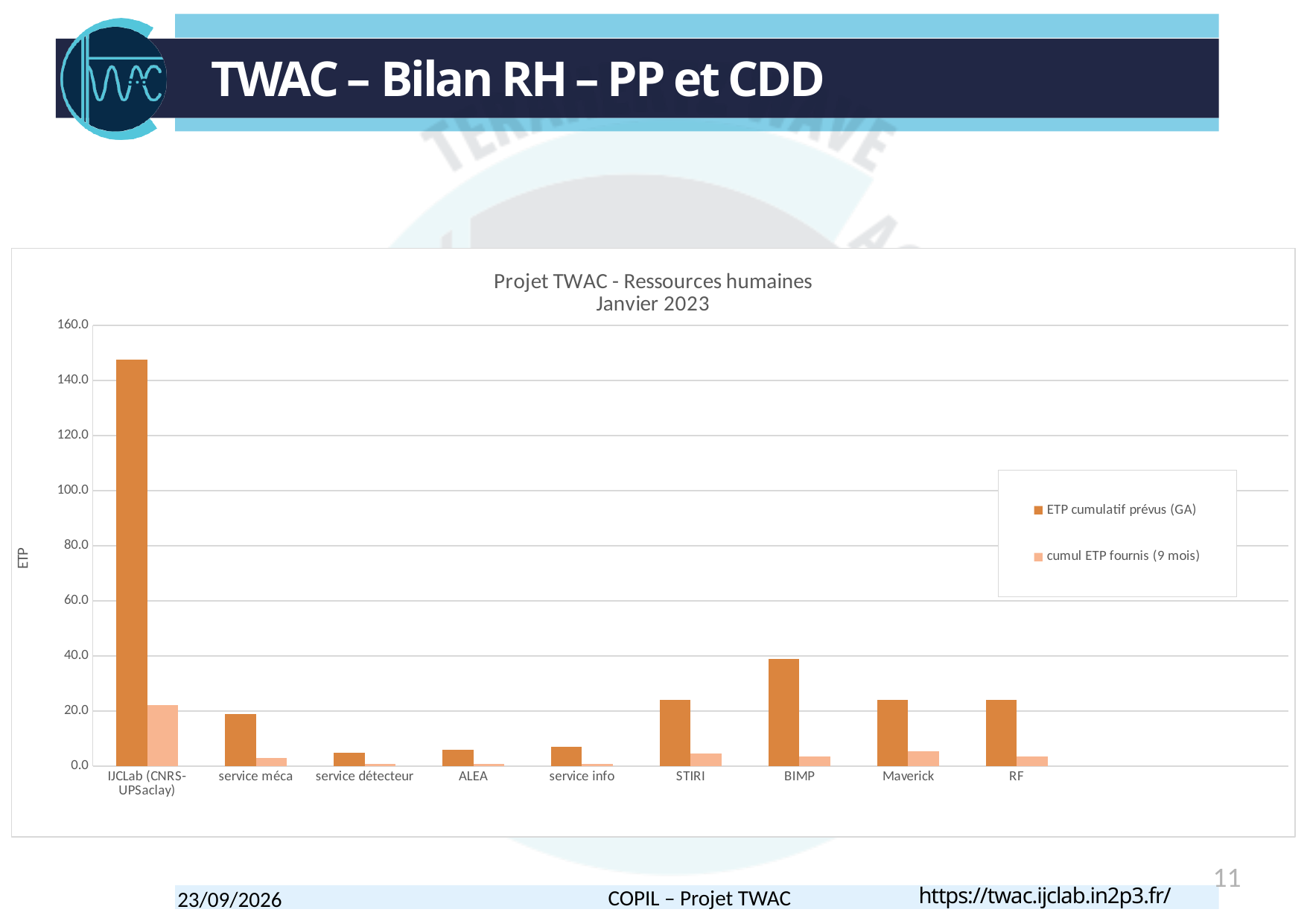
Which category has the highest value for ETP cumulatif prévus (GA)? IJCLab (CNRS-UPSaclay) Which is larger, the ETP cumulatif prévus (GA) value for BIMP or for STIRI? BIMP How many categories are shown on the x axis? 9 Is the ETP cumulatif prévus (GA) value for BIMP greater or less than 20? greater Is the cumul ETP fournis (9 mois) value for Maverick greater or less than 20? less What kind of chart is shown on the slide? bar chart How many series does the legend list? 2 Is the ETP cumulatif prévus (GA) value for service info greater or less than 20? less Which category has the highest value for cumul ETP fournis (9 mois)? IJCLab (CNRS-UPSaclay) For IJCLab (CNRS-UPSaclay), which series has the larger value, ETP cumulatif prévus (GA) or cumul ETP fournis (9 mois)? ETP cumulatif prévus (GA) What is the label of the y axis? ETP